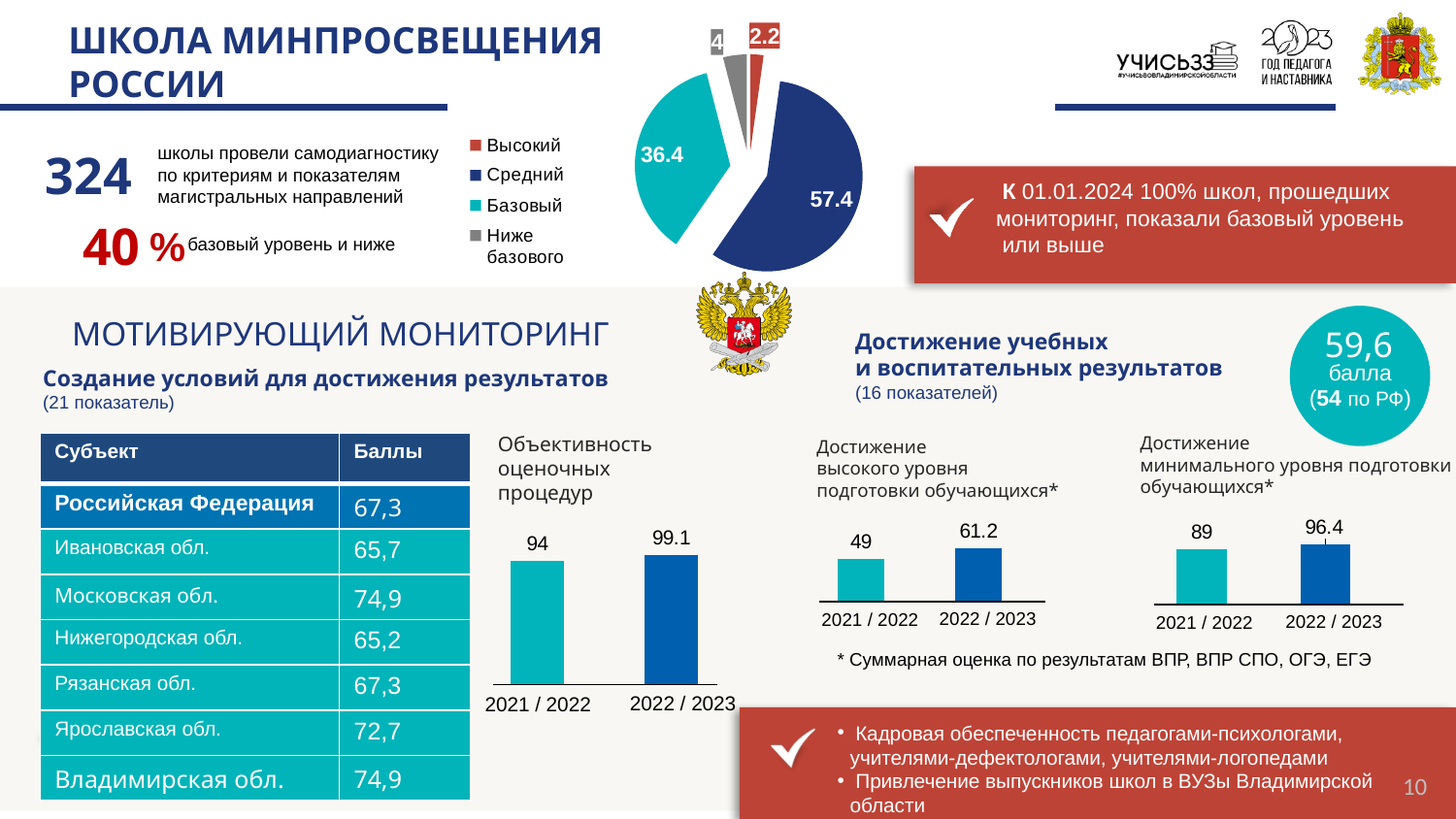
What type of chart is used for 'Достижение минимального уровня подготовки обучающихся'? bar chart In the pie chart at the top of the slide, what is the difference between the Средний and Базовый values? 21 In the pie chart at the top of the slide, which category has the smallest slice? Высокий In the pie chart at the top of the slide, what is the value of the Базовый slice? 36.4 In the pie chart at the top of the slide, which category has the largest slice? Средний In the chart titled 'Объективность оценочных процедур', what is the value for 2021 / 2022? 94 How many categories does the legend of the pie chart at the top of the slide list? 4 In the chart titled 'Достижение минимального уровня подготовки обучающихся', what is the value for 2021 / 2022? 89 In the chart titled 'Достижение высокого уровня подготовки обучающихся', by how much did the value increase from 2021 / 2022 to 2022 / 2023? 12.2 In the chart titled 'Объективность оценочных процедур', what is the value for 2022 / 2023? 99.1 In the pie chart at the top of the slide, what is the value of the Средний slice? 57.4 In the chart titled 'Достижение высокого уровня подготовки обучающихся', what is the value for 2022 / 2023? 61.2